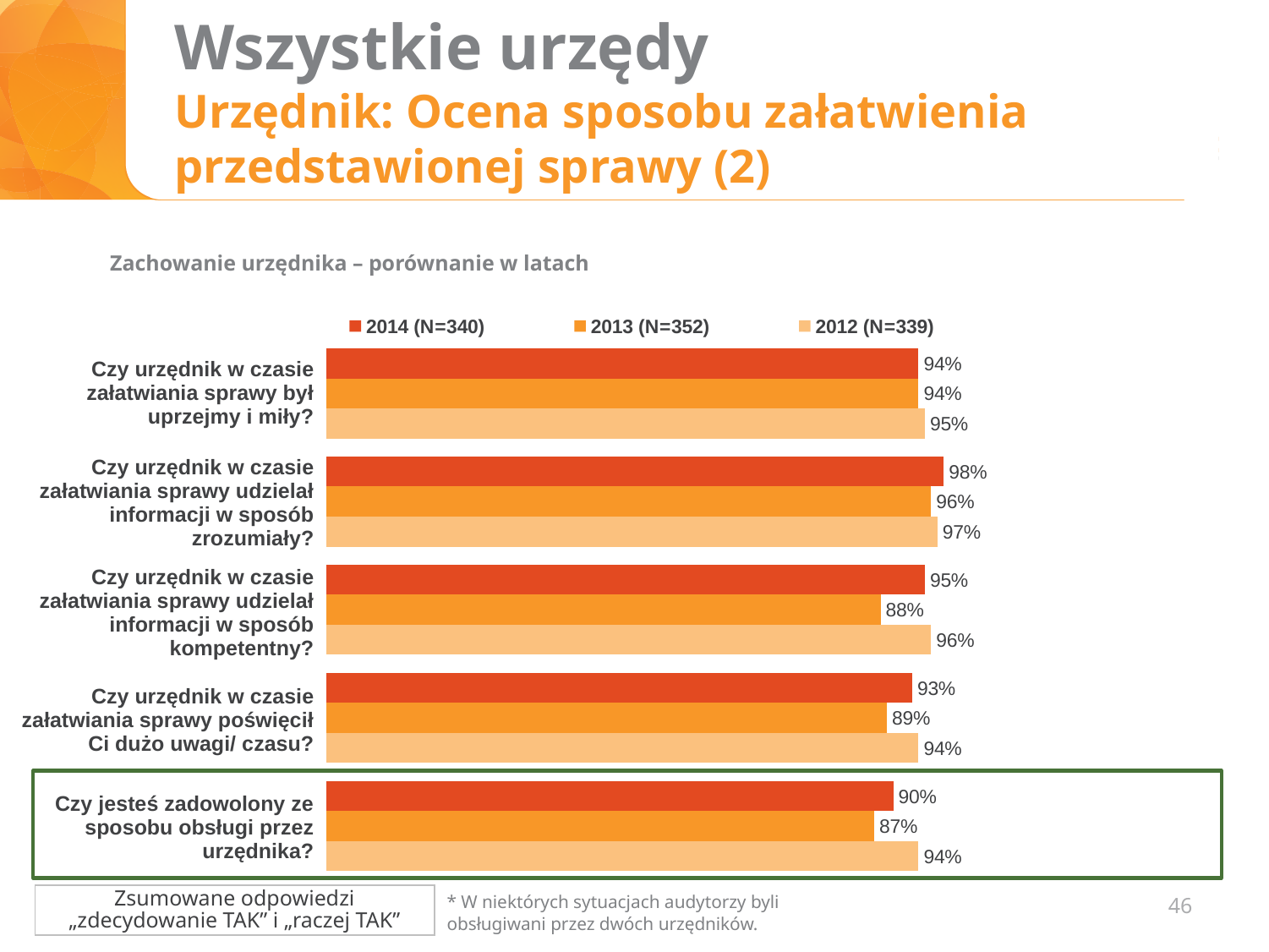
What kind of chart is shown on the slide? bar chart What is the subtitle shown above the chart? Zachowanie urzędnika – porównanie w latach How many series does the legend list? 3 How many question categories are plotted on the chart? 5 What sample size (N) is given in the legend for 2013? N=352 For "Czy jesteś zadowolony ze sposobu obsługi przez urzędnika?", which year has the larger value, 2012 or 2014? 2012 What is the 2012 value for "Czy urzędnik w czasie załatwiania sprawy poświęcił Ci dużo uwagi/ czasu?"? 94% What is the 2014 value for "Czy urzędnik w czasie załatwiania sprawy udzielał informacji w sposób zrozumiały?"? 98% Which question category has the highest 2014 value? Czy urzędnik w czasie załatwiania sprawy udzielał informacji w sposób zrozumiały? What is the 2013 value for "Czy jesteś zadowolony ze sposobu obsługi przez urzędnika?"? 87% What is the difference between the 2014 and 2013 values for "Czy urzędnik w czasie załatwiania sprawy udzielał informacji w sposób kompetentny?"? 7 percentage points Which question category has the lowest 2013 value? Czy jesteś zadowolony ze sposobu obsługi przez urzędnika?